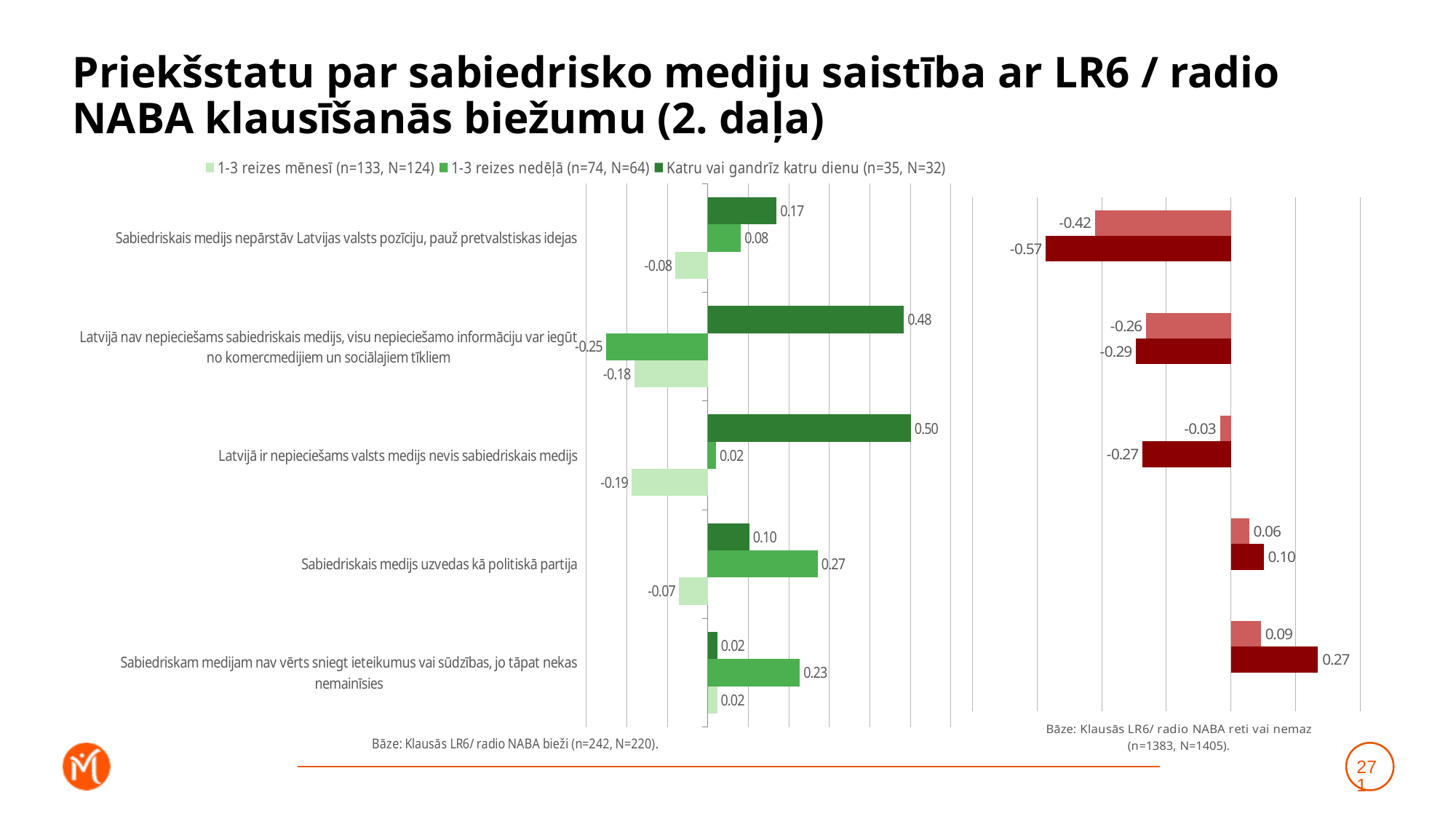
What kind of chart is the right chart (Bāze: Klausās LR6/ radio NABA reti vai nemaz)? Bar chart In the left chart (Bāze: Klausās LR6/ radio NABA bieži), what is the value for 'Katru vai gandrīz katru dienu' for 'Latvijā ir nepieciešams valsts medijs nevis sabiedriskais medijs'? 0.50 In the left chart (Bāze: Klausās LR6/ radio NABA bieži), which category has the highest value for 'Katru vai gandrīz katru dienu'? Latvijā ir nepieciešams valsts medijs nevis sabiedriskais medijs In the left chart (Bāze: Klausās LR6/ radio NABA bieži), which category has the lowest value for '1-3 reizes nedēļā'? Latvijā nav nepieciešams sabiedriskais medijs, visu nepieciešamo informāciju var iegūt no komercmedijiem un sociālajiem tīkliem In the left chart (Bāze: Klausās LR6/ radio NABA bieži), what is the value for '1-3 reizes nedēļā' for 'Sabiedriskais medijs uzvedas kā politiskā partija'? 0.27 In the right chart (Bāze: Klausās LR6/ radio NABA reti vai nemaz), which category has the highest dark red bar value? Sabiedriskam medijam nav vērts sniegt ieteikumus vai sūdzības, jo tāpat nekas nemainīsies How many categories are shown in the left chart (Bāze: Klausās LR6/ radio NABA bieži)? 5 In the left chart (Bāze: Klausās LR6/ radio NABA bieži), what is the value for '1-3 reizes mēnesī' for 'Latvijā nav nepieciešams sabiedriskais medijs, visu nepieciešamo informāciju var iegūt no komercmedijiem un sociālajiem tīkliem'? -0.18 In the right chart (Bāze: Klausās LR6/ radio NABA reti vai nemaz), what is the value of the dark red bar for 'Sabiedriskais medijs nepārstāv Latvijas valsts pozīciju, pauž pretvalstiskas idejas'? -0.57 In the left chart (Bāze: Klausās LR6/ radio NABA bieži), what is the difference between the 'Katru vai gandrīz katru dienu' value and the '1-3 reizes nedēļā' value for 'Sabiedriskais medijs nepārstāv Latvijas valsts pozīciju, pauž pretvalstiskas idejas'? 0.09 In the left chart (Bāze: Klausās LR6/ radio NABA bieži), which is larger for 'Sabiedriskam medijam nav vērts sniegt ieteikumus vai sūdzības, jo tāpat nekas nemainīsies': the '1-3 reizes nedēļā' value or the 'Katru vai gandrīz katru dienu' value? 1-3 reizes nedēļā How many series does the legend of the left chart (Bāze: Klausās LR6/ radio NABA bieži) list? 3